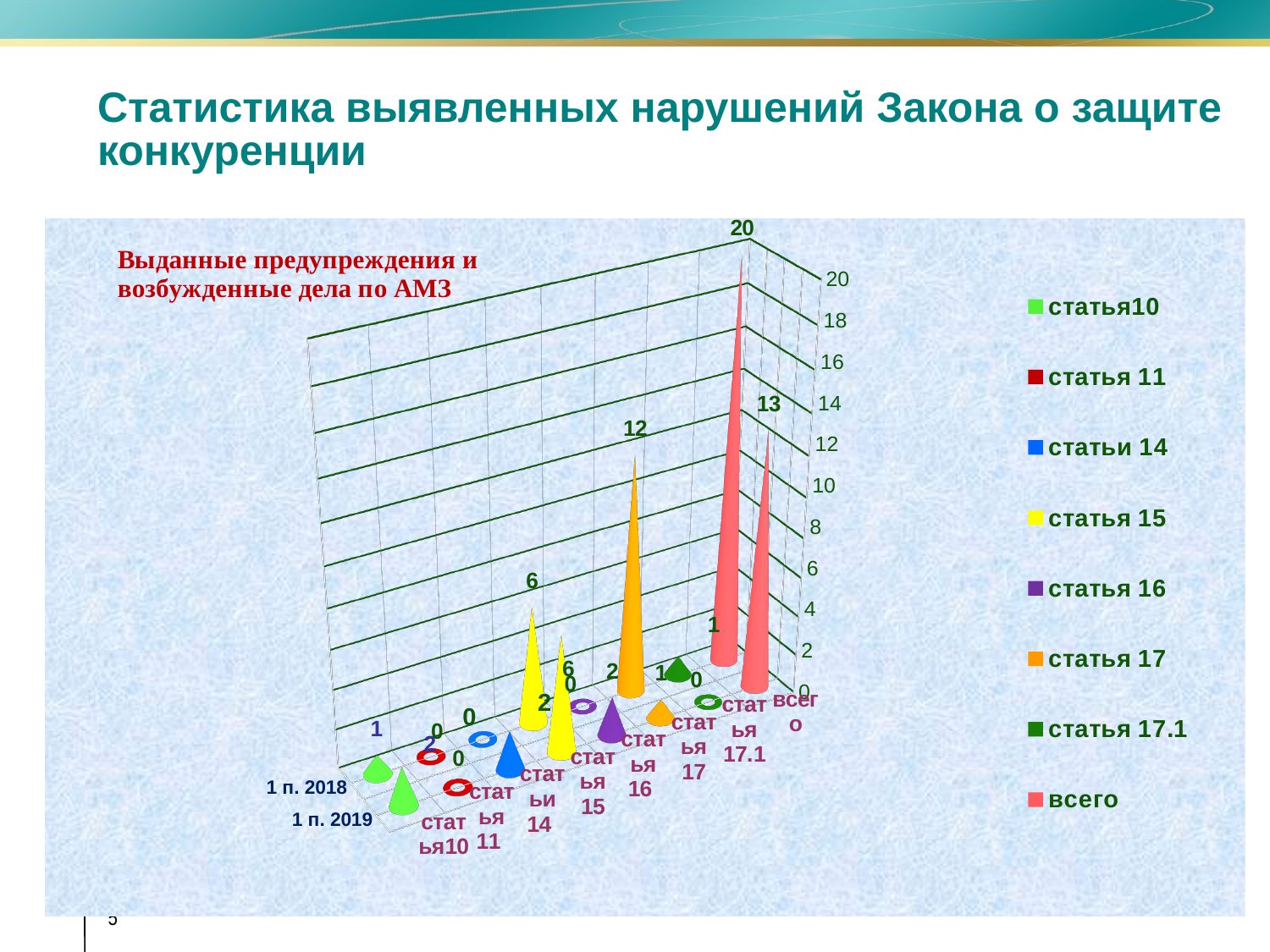
What kind of chart is shown on the slide? bar chart What is the difference between the всего values for 1 п. 2018 and 1 п. 2019? 7 What is the value for статья 15 in 1 п. 2018? 6 What is the value for всего in 1 п. 2018? 20 Which category has the highest value in 1 п. 2018? всего What is the value for статья 17 in 1 п. 2018? 12 What is the value for всего in 1 п. 2019? 13 What is the value for статья 11 in 1 п. 2019? 0 How many categories are shown along the category axis? 8 Which is larger in 1 п. 2018: статья 17 or статья 15? статья 17 What is the title of the chart? Выданные предупреждения и возбужденные дела по АМЗ How many series does the legend list? 8